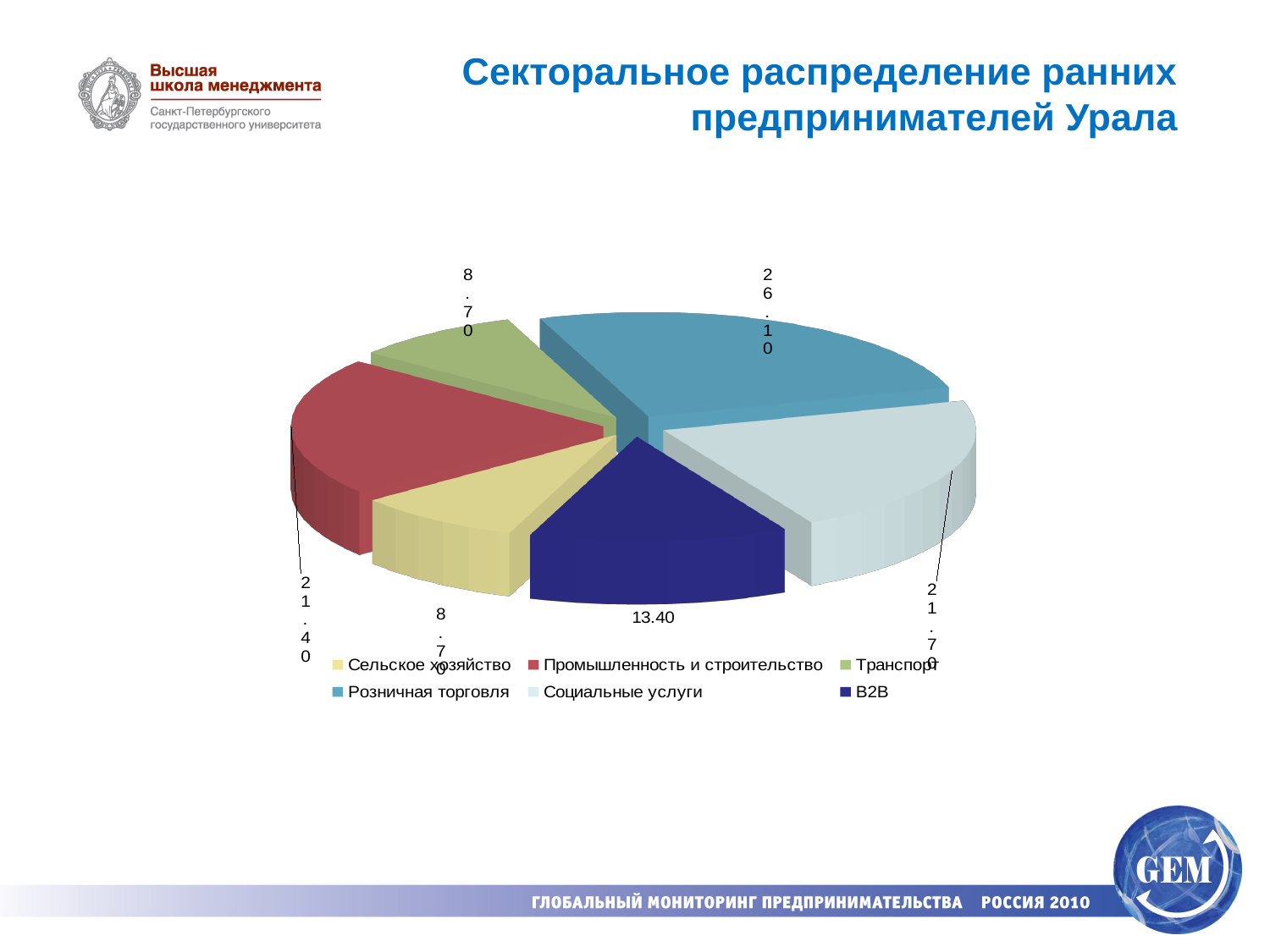
What is the value for B2B? 13.40 What is the value for Социальные услуги? 21.70 Which is larger, Розничная торговля or B2B? Розничная торговля What is the value for Сельское хозяйство? 8.70 What is the title of the chart? Секторальное распределение ранних предпринимателей Урала What is the value for Промышленность и строительство? 21.40 Which category has the largest slice? Розничная торговля What is the value for Розничная торговля? 26.10 What is the difference between the values for Розничная торговля and B2B? 12.70 How many categories does the pie chart have? 6 What is the value for Транспорт? 8.70 What type of chart is shown on the slide? pie chart